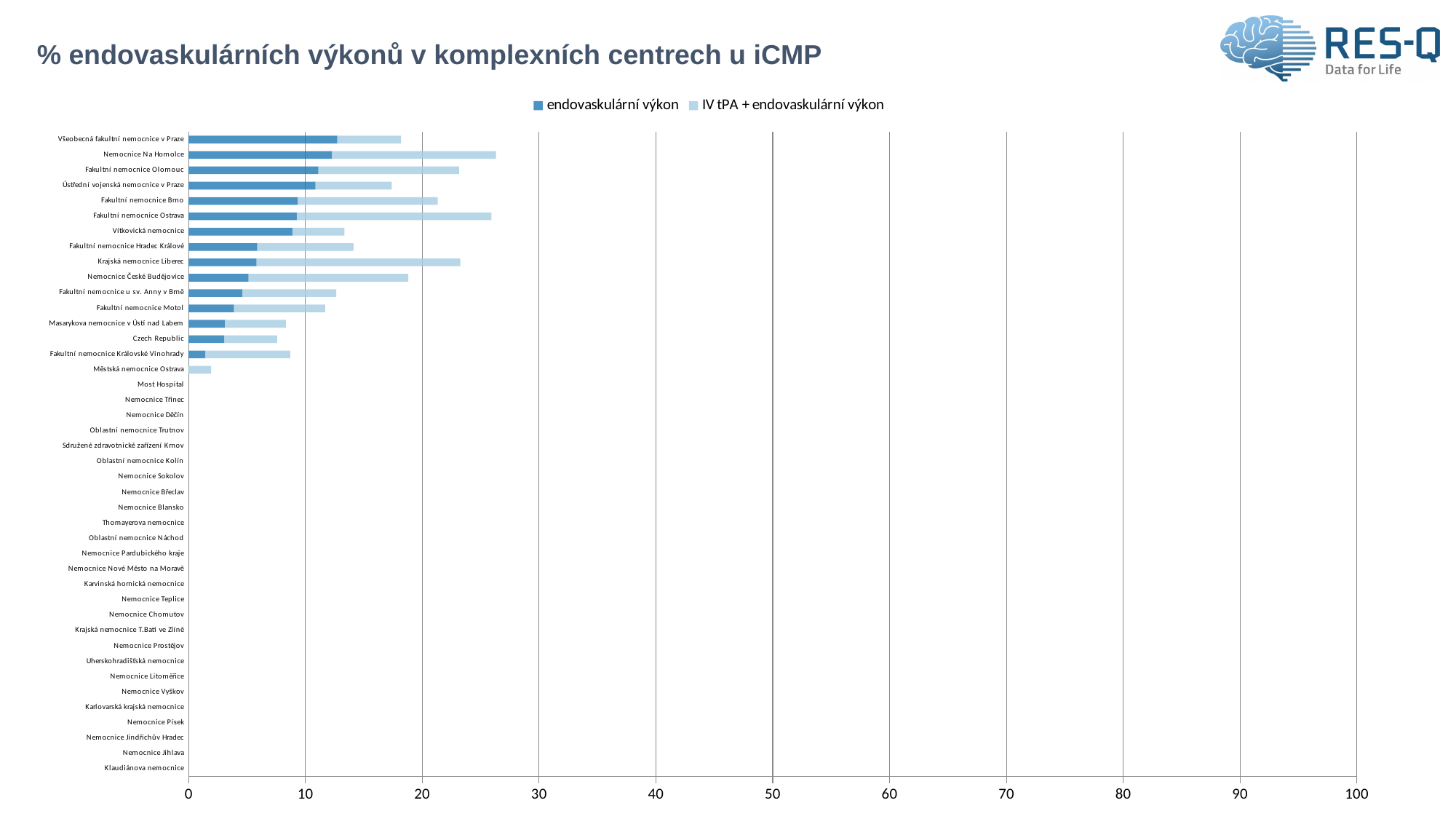
Which has the larger endovaskulární výkon value, Fakultní nemocnice Olomouc or Fakultní nemocnice Motol? Fakultní nemocnice Olomouc Is the endovaskulární výkon value for Czech Republic greater or less than 10? less Is the total bar length for Fakultní nemocnice Ostrava greater or less than 20? greater What is the title of the chart? % endovaskulárních výkonů v komplexních centrech u iCMP How many hospitals (categories) are listed on the vertical axis? 42 Which series is shown in the darker blue colour? endovaskulární výkon Is the total bar length for Nemocnice Na Homolce greater or less than 20? greater What kind of chart is shown on the slide? bar chart How many series does the legend list? 2 Which has the longer total bar, Krajská nemocnice Liberec or Fakultní nemocnice Hradec Králové? Krajská nemocnice Liberec